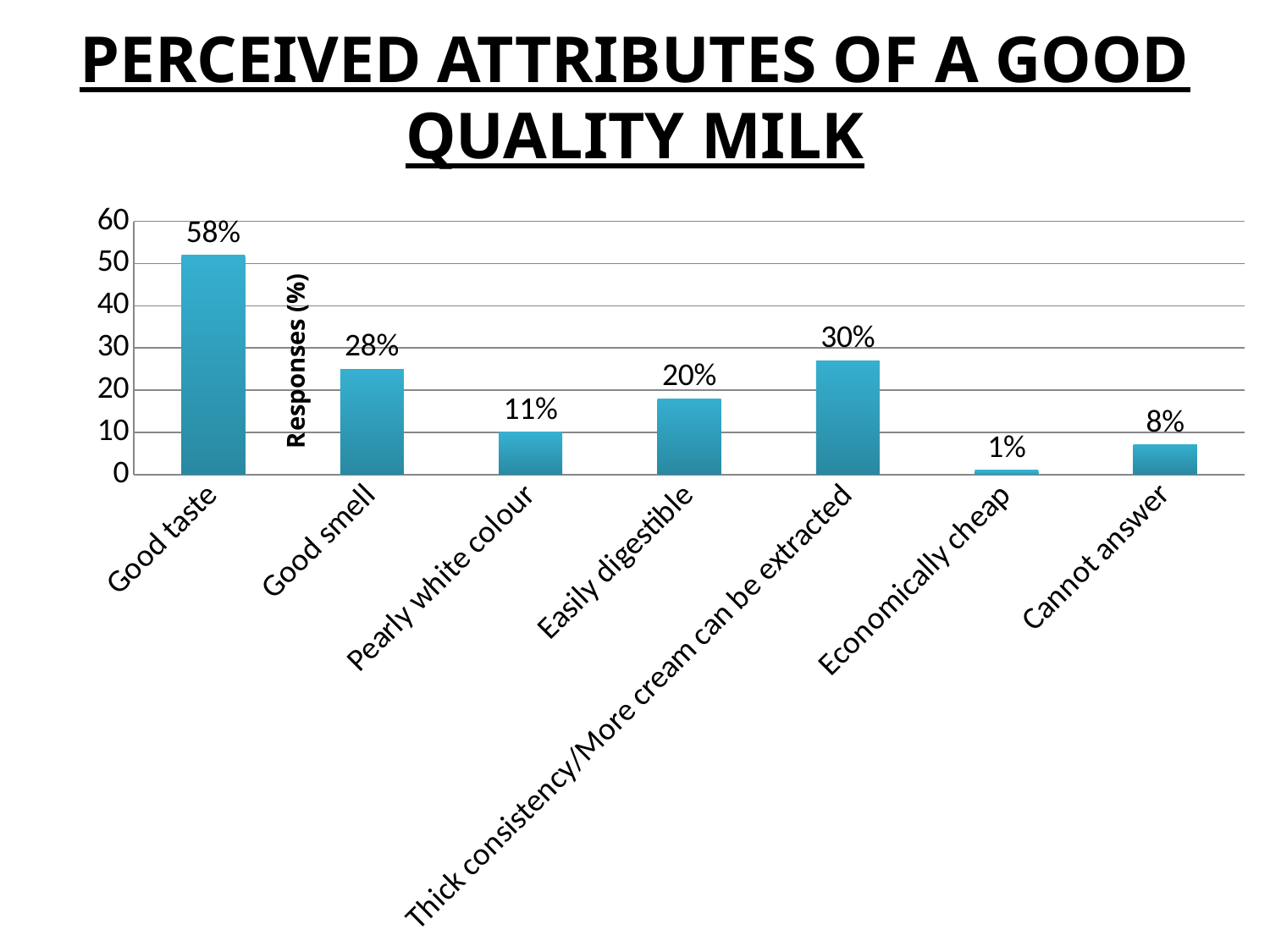
What kind of chart is shown on the slide? Bar chart How many categories are shown on the x axis? 7 What is the label of the vertical axis? Responses (%) Which is larger, the value for Good smell or the value for Thick consistency/More cream can be extracted? Thick consistency/More cream can be extracted What is the value for Economically cheap? 1% What is the difference between the values for Good taste and Good smell? 30% What is the value for Good taste? 58% What is the difference between the values for Easily digestible and Pearly white colour? 9% What is the value for Thick consistency/More cream can be extracted? 30% What is the value for Cannot answer? 8% Which category has the highest value? Good taste Which category has the lowest value? Economically cheap